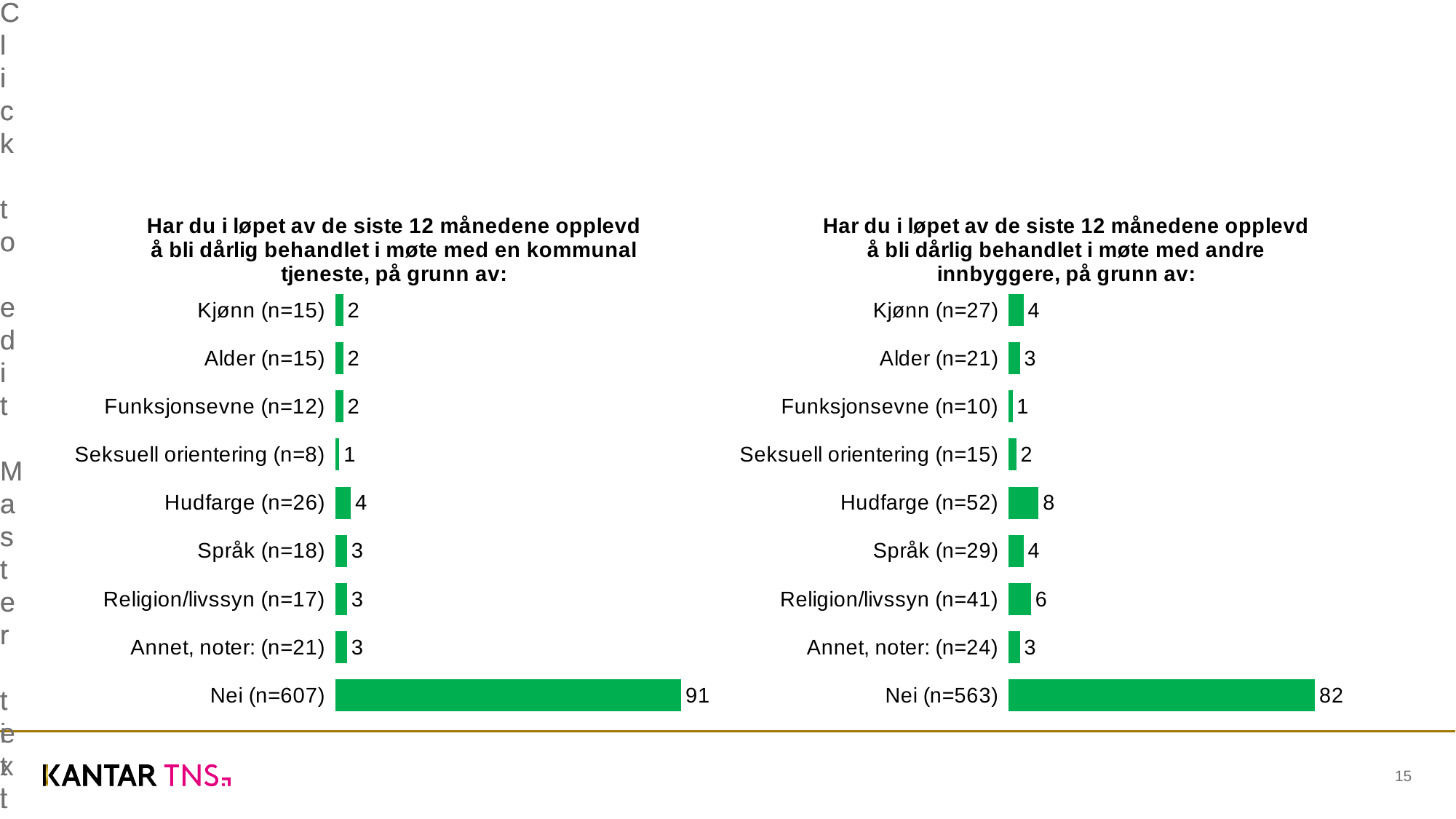
In the right chart (andre innbyggere), what is the value for Religion/livssyn (n=41)? 6 In the right chart (andre innbyggere), which category has the lowest value? Funksjonsevne (n=10) In the left chart (kommunal tjeneste), which category has the lowest value? Seksuell orientering (n=8) In the right chart (andre innbyggere), which category has the highest value? Nei (n=563) In the left chart (kommunal tjeneste), what is the value for Nei (n=607)? 91 What is the difference between the Nei value in the left chart (91) and the Nei value in the right chart (82)? 9 In the right chart (andre innbyggere), what is the value for Hudfarge (n=52)? 8 How many categories are shown in the left chart (kommunal tjeneste)? 9 In the right chart (andre innbyggere), what is the difference between Hudfarge (n=52) and Kjønn (n=27)? 4 Is the value for Hudfarge larger in the left chart (kommunal tjeneste) or in the right chart (andre innbyggere)? Right chart (andre innbyggere) What type of chart is used on this slide? Bar chart What colour are the bars in both charts? Green